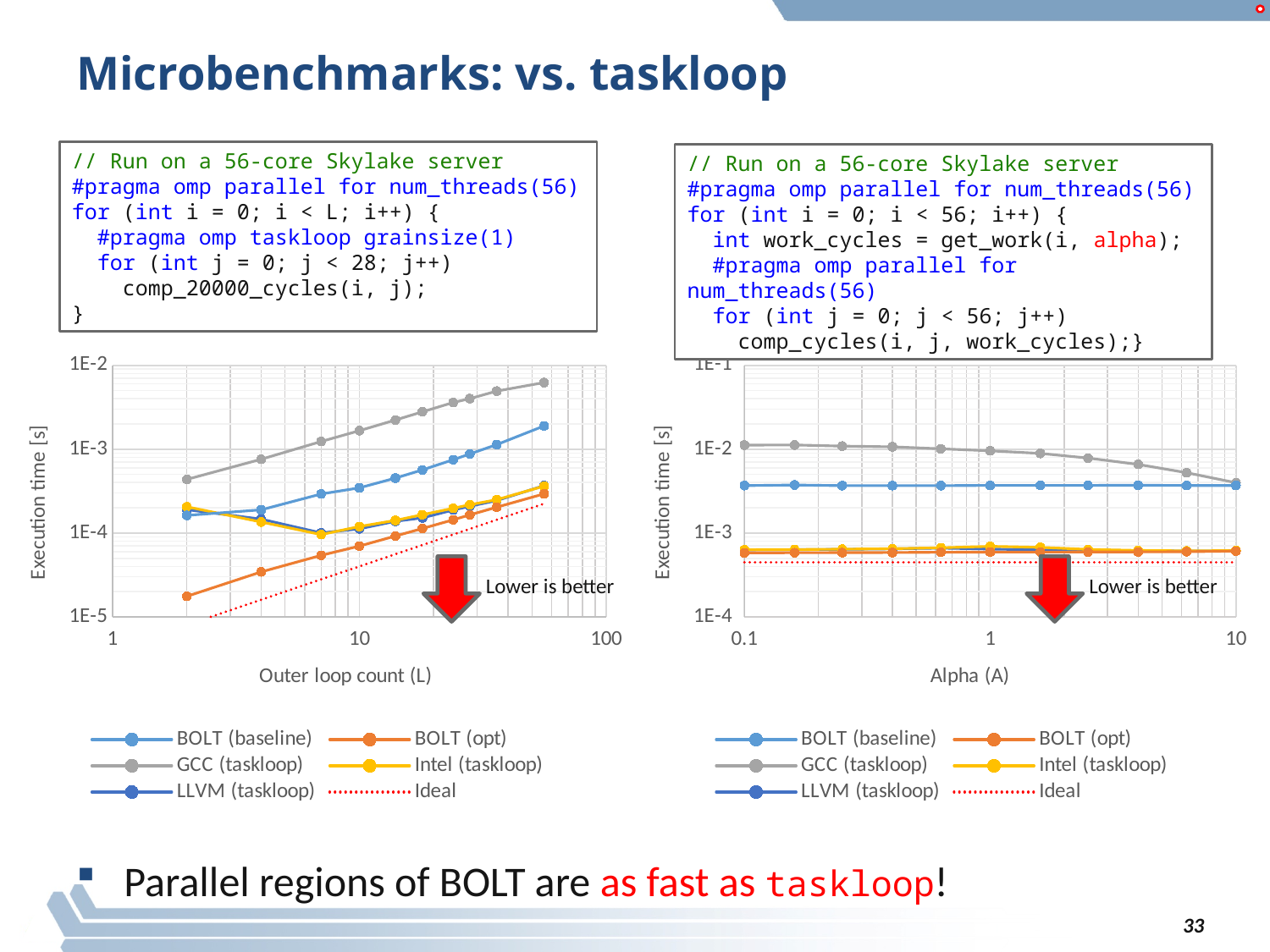
What is the x-axis label of the right chart? Alpha (A) In the left chart, which series has the highest execution time across the outer loop counts? GCC (taskloop) In the left chart, is the execution time of GCC (taskloop) at outer loop count 56 greater or less than 1E-3? greater In the right chart, does the execution time of GCC (taskloop) rise or fall as alpha increases? fall What kind of chart is the left chart (Outer loop count)? line chart How many series does the legend of the left chart list? 6 In the left chart, which is larger at outer loop count 2: the execution time of GCC (taskloop) or BOLT (opt)? GCC (taskloop) In the right chart, which series has the highest execution time at alpha 1? GCC (taskloop) In the left chart, is the execution time of BOLT (opt) at outer loop count 2 greater or less than 1E-4? less In the right chart, is the execution time of BOLT (baseline) at alpha 1 greater or less than 1E-3? greater In the left chart, does the execution time of GCC (taskloop) rise or fall as the outer loop count increases? rise